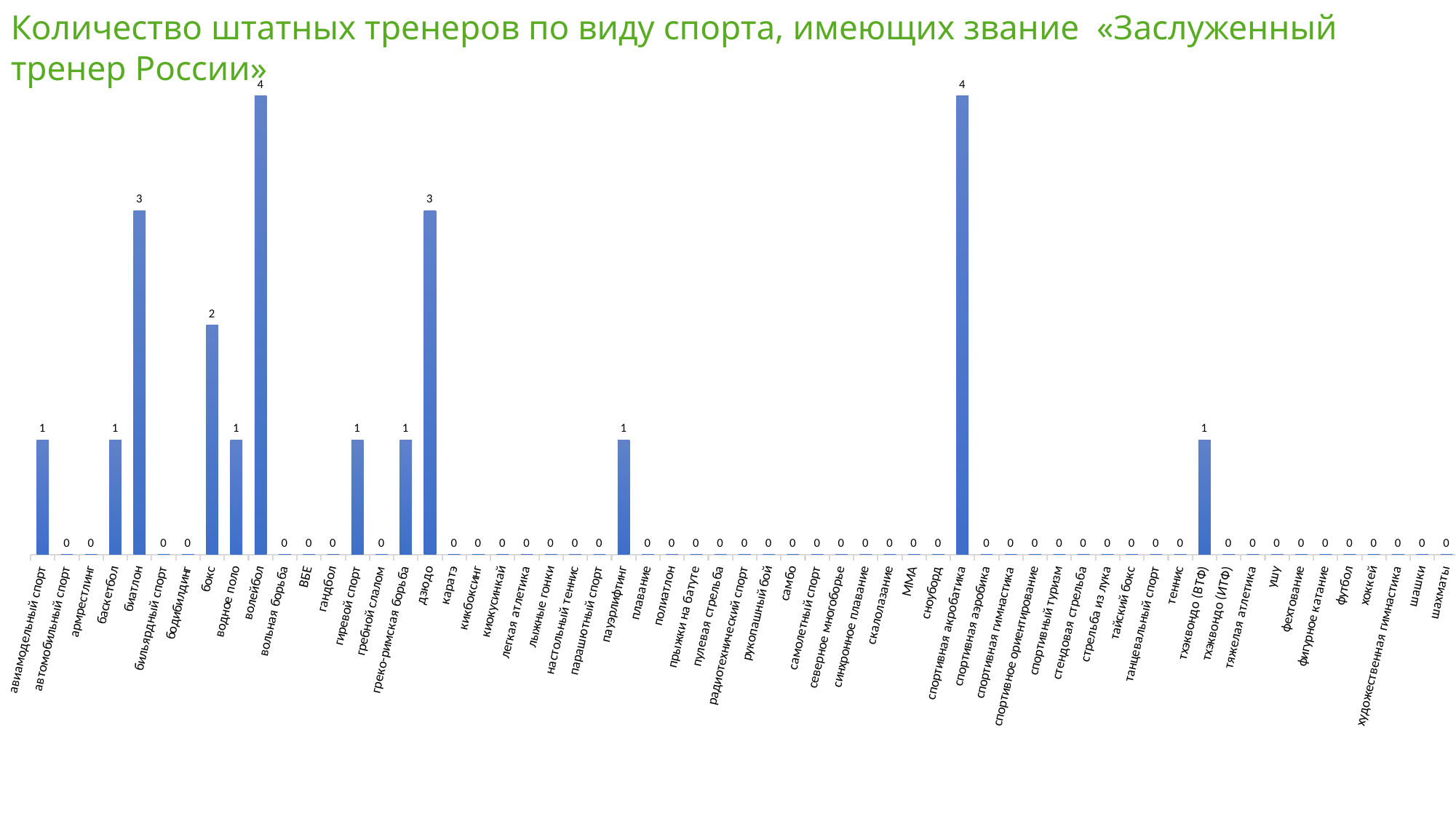
What is the highest value shown in the chart? 4 Which two sports share the highest value in the chart? волейбол and спортивная акробатика How many staff coaches with the title 'Заслуженный тренер России' are there in биатлон? 3 Which has a larger value, биатлон or баскетбол? биатлон What is the title of the chart? Количество штатных тренеров по виду спорта, имеющих звание «Заслуженный тренер России» What is the value for футбол? 0 What type of chart is shown on the slide? bar chart What is the value for дзюдо? 3 What is the value for тхэквондо (ВТФ)? 1 What is the value for волейбол? 4 What is the value for бокс? 2 What is the difference between the values for волейбол and бокс? 2